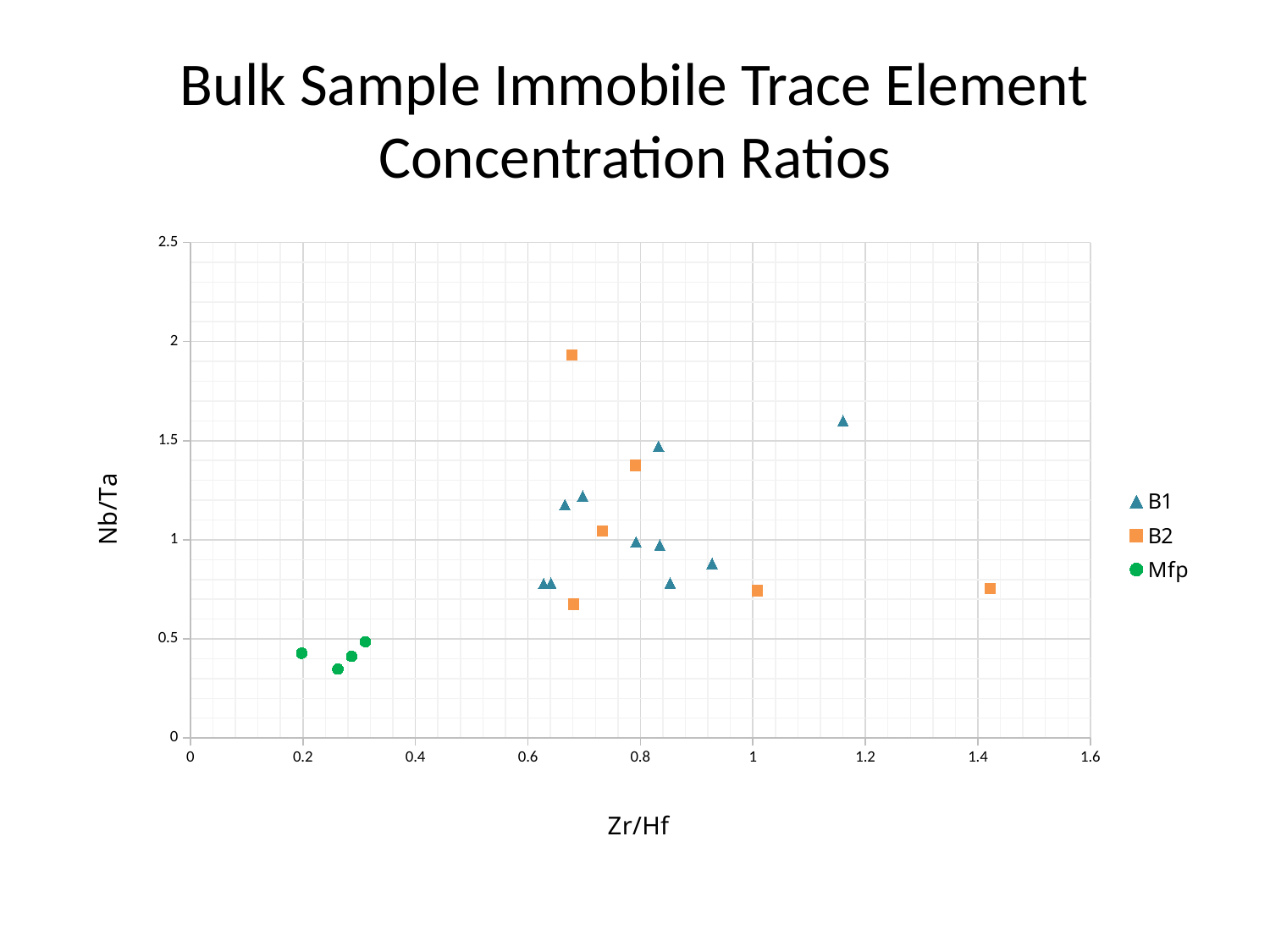
Which series contains the point with the largest Zr/Hf value? B2 How many B2 points are plotted? 6 Which series contains the point with the highest Nb/Ta value? B2 What is the label of the vertical axis? Nb/Ta Is the Nb/Ta value of the highest B2 point greater or less than 1.5? greater Which series has the lowest Nb/Ta values overall? Mfp Are the Zr/Hf values of all Mfp points greater or less than 0.4? less Is the highest Nb/Ta value among B1 points greater or less than the highest Nb/Ta value among B2 points? less How many Mfp points are plotted? 4 What is the title of the chart? Bulk Sample Immobile Trace Element Concentration Ratios What kind of chart is shown on the slide? Scatter chart How many series does the legend list? 3